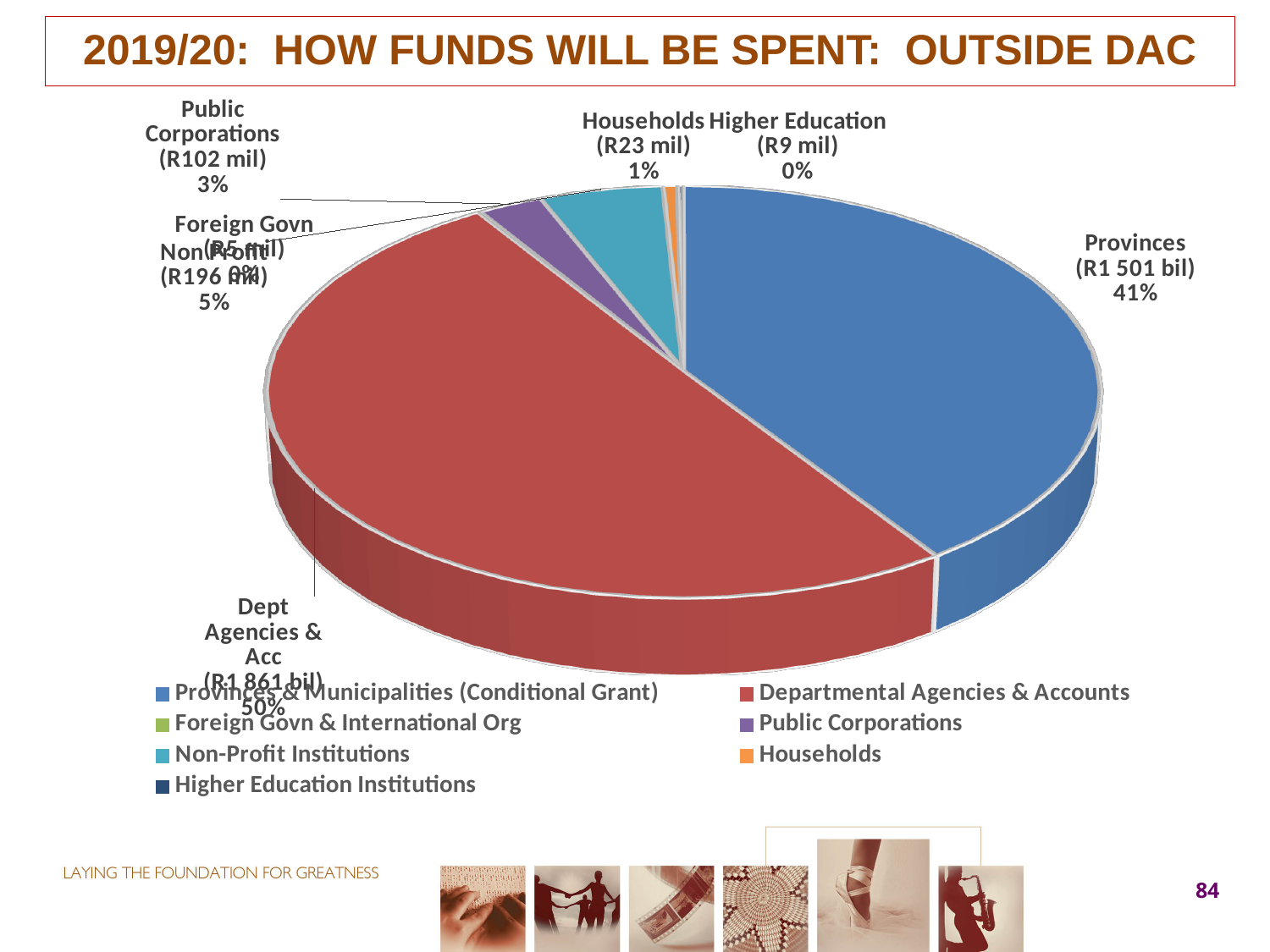
Which category has the largest share of the pie? Dept Agencies & Acc What is the difference in percentage points between the Dept Agencies & Acc share and the Provinces share? 9 percentage points What share of the pie does Dept Agencies & Acc represent? 50% What kind of chart is shown on the slide? Pie chart What amount is shown for Higher Education? R9 mil What amount is shown for Households? R23 mil What share of the pie does Provinces represent? 41% How many entries does the legend list? 7 What amount is shown for Provinces? R1 501 bil Which is larger, the share for Public Corporations or the share for Households? Public Corporations What amount is shown for Dept Agencies & Acc? R1 861 bil What amount is shown for Public Corporations? R102 mil